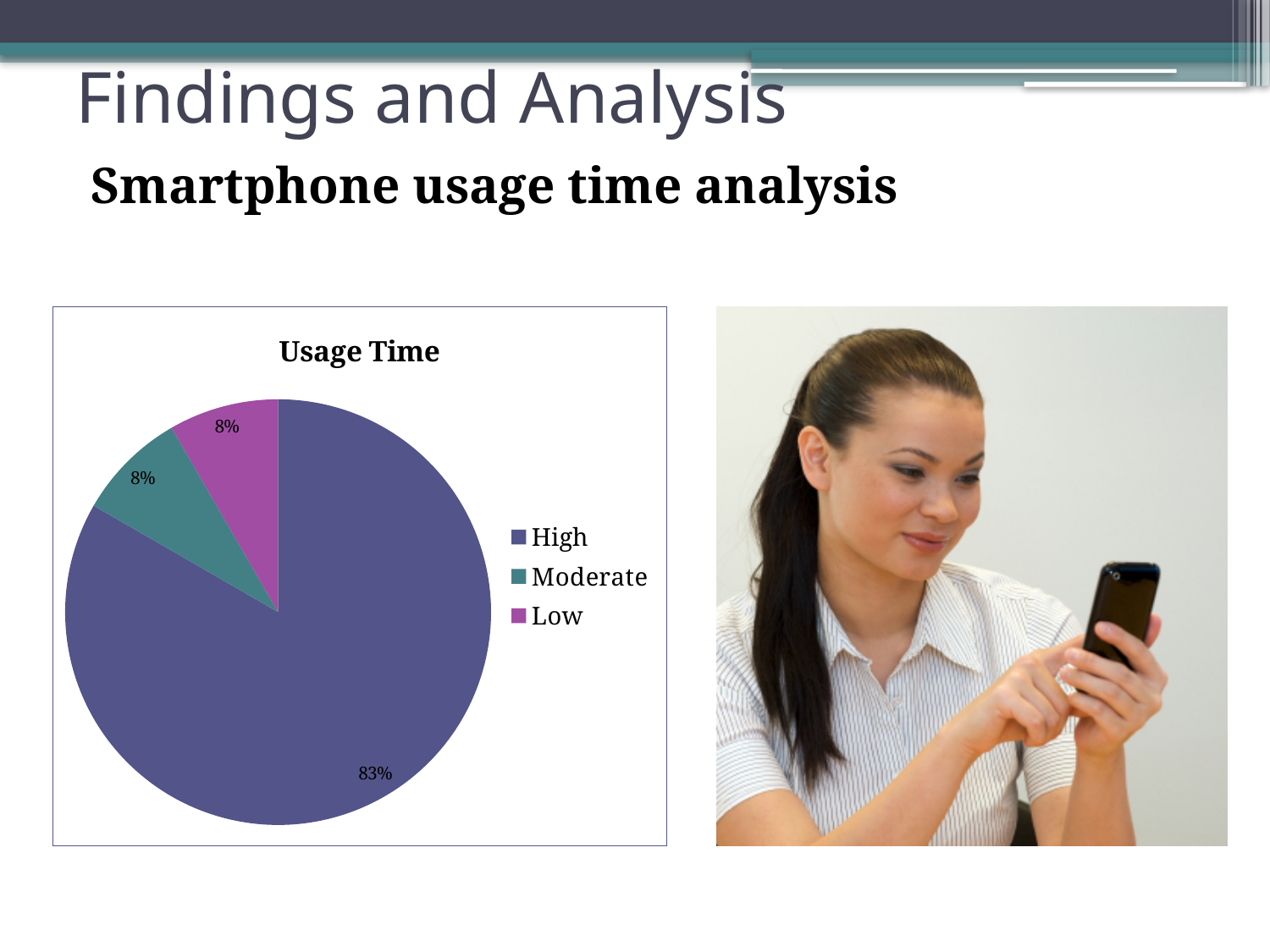
What is the title of the chart? Usage Time Which category has the largest slice of the pie? High Which categories are listed in the legend? High, Moderate, Low Is the value for High greater or less than 50%? greater Which is larger, the High slice or the Moderate slice? High What share of the pie does the High category have? 83% What share of the pie does the Low category have? 8% What is the difference between the High share and the Low share? 75% What kind of chart is shown on the slide? Pie chart How many categories does the pie chart show? 3 What share of the pie does the Moderate category have? 8%